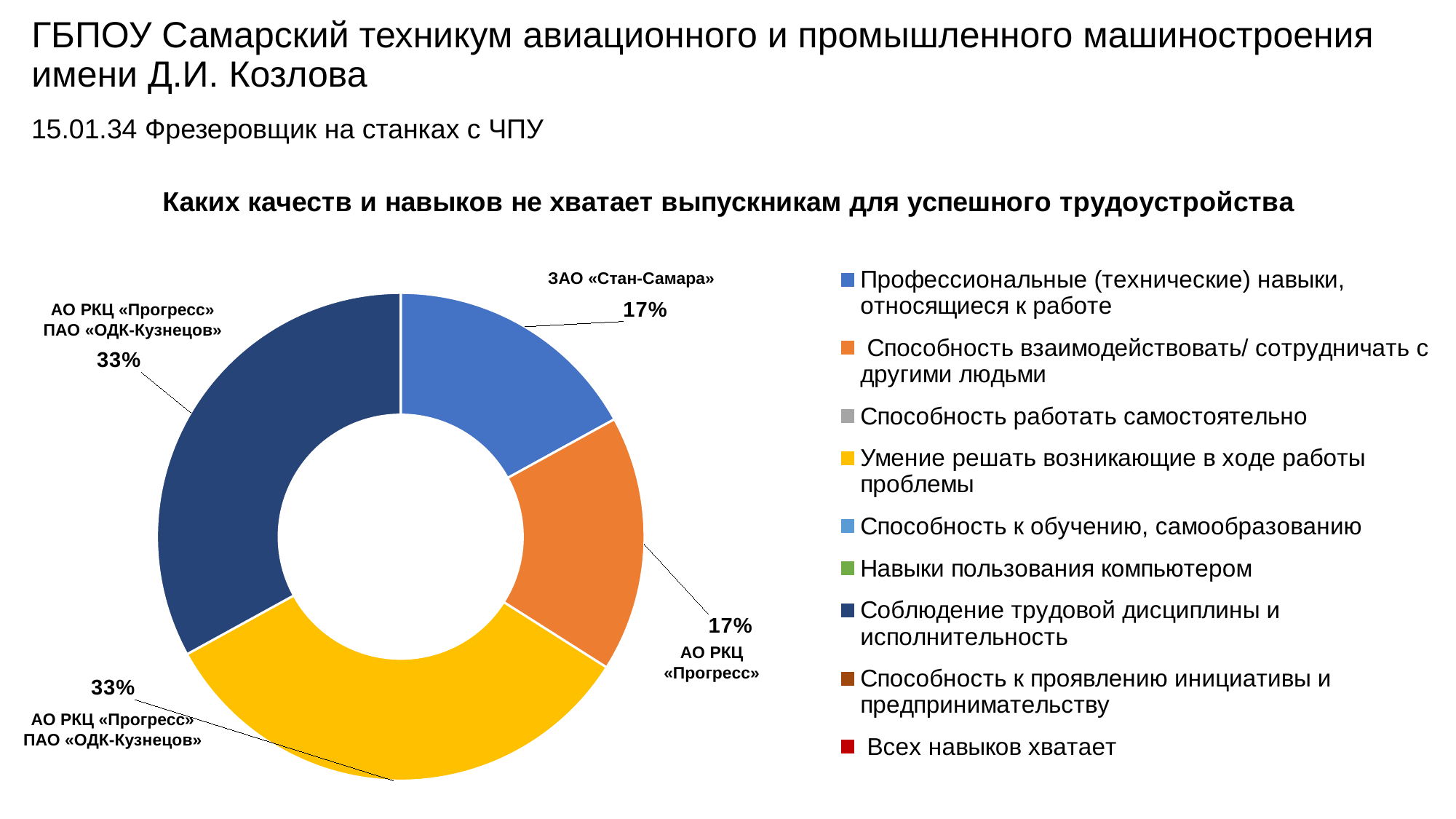
How many entries does the chart legend list? 9 How many slices with data labels are visible in the chart? 4 What is the title of the chart? Каких качеств и навыков не хватает выпускникам для успешного трудоустройства What share is shown for «Умение решать возникающие в ходе работы проблемы»? 33% What is the difference in percentage points between the share for «Соблюдение трудовой дисциплины и исполнительность» and the share for «Способность взаимодействовать/ сотрудничать с другими людьми»? 16 What share is shown for «Профессиональные (технические) навыки, относящиеся к работе»? 17% What share is shown for «Соблюдение трудовой дисциплины и исполнительность»? 33% What kind of chart is shown on the slide? doughnut (pie) chart Which is larger: the share for «Умение решать возникающие в ходе работы проблемы» or the share for «Профессиональные (технические) навыки, относящиеся к работе»? Умение решать возникающие в ходе работы проблемы What colour represents «Умение решать возникающие в ходе работы проблемы» in the chart? yellow What share is shown for «Способность взаимодействовать/ сотрудничать с другими людьми»? 17% Which employer is labelled next to the 17% slice for «Профессиональные (технические) навыки, относящиеся к работе»? ЗАО «Стан-Самара»